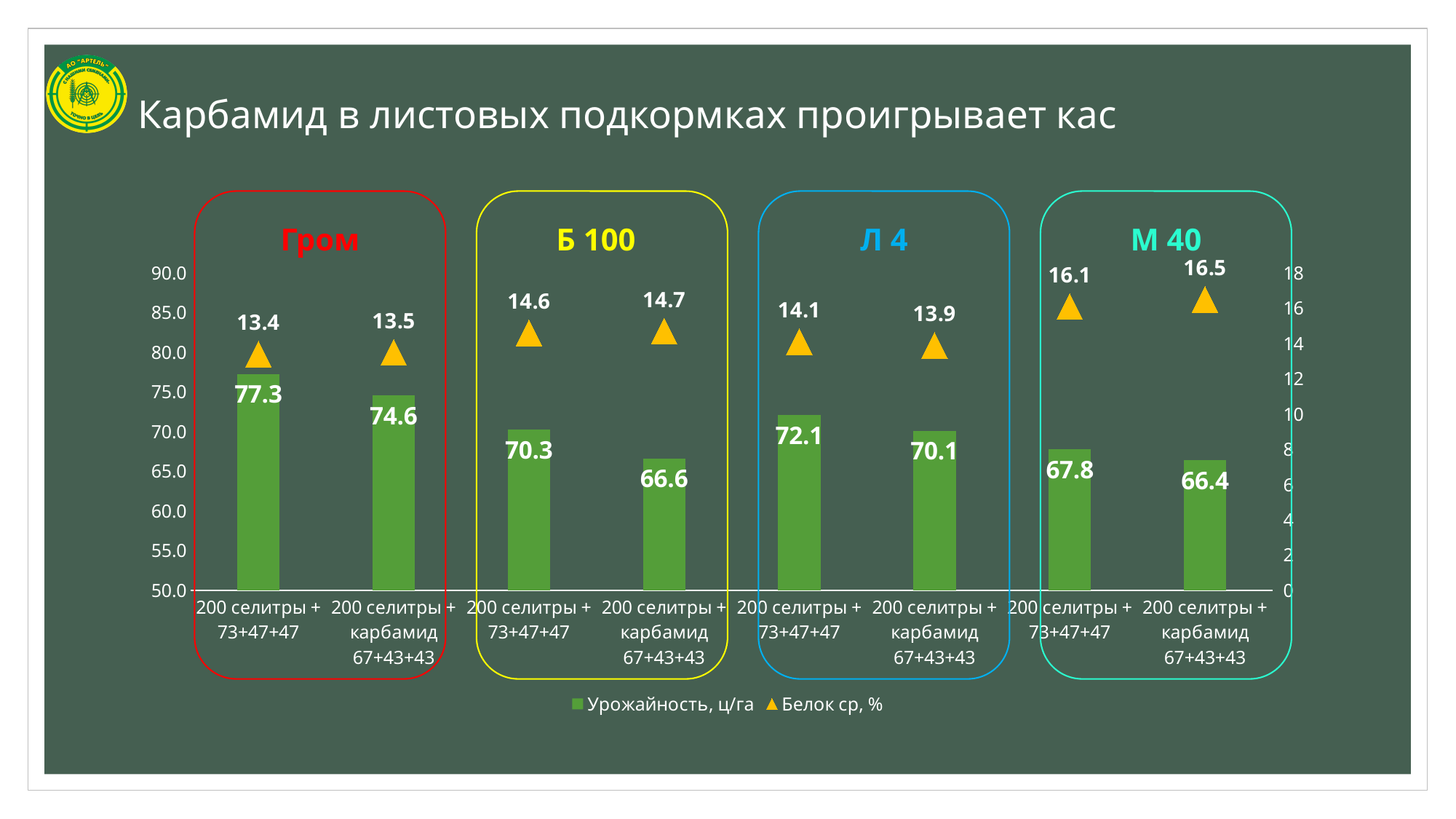
What is the protein value (Белок ср, %) for М 40 with the treatment 200 селитры + карбамид 67+43+43? 16.5 What is the title of the slide? Карбамид в листовых подкормках проигрывает кас What is the protein value (Белок ср, %) for Л 4 with the treatment 200 селитры + 73+47+47? 14.1 For Л 4, which treatment gives the higher yield: 200 селитры + 73+47+47 or 200 селитры + карбамид 67+43+43? 200 селитры + 73+47+47 Which bar has the lowest yield (Урожайность, ц/га) on the chart? М 40, 200 селитры + карбамид 67+43+43 (66.4) What is the difference in yield between the two treatments for Б 100? 3.7 What is the yield (Урожайность, ц/га) for Б 100 with the treatment 200 селитры + карбамид 67+43+43? 66.6 What is the difference in yield between the two treatments for Гром? 2.7 Which bar has the highest yield (Урожайность, ц/га) on the chart? Гром, 200 селитры + 73+47+47 (77.3) What is the yield (Урожайность, ц/га) for Гром with the treatment 200 селитры + 73+47+47? 77.3 How many bars are plotted on the chart? 8 How many series does the legend list? 2